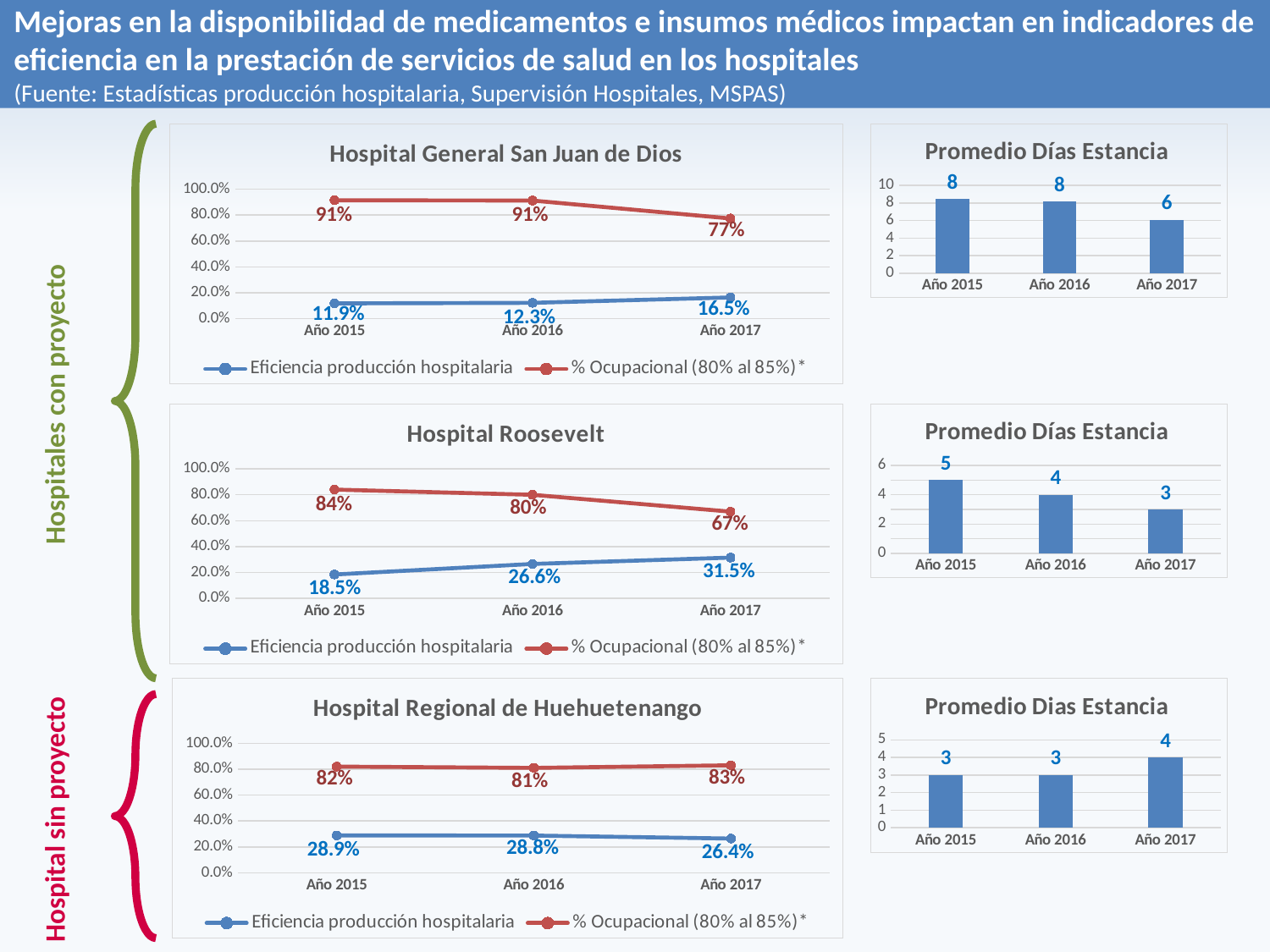
In the Hospital Roosevelt chart, what is the difference between the % Ocupacional values for Año 2015 and Año 2017? 17% In the Hospital General San Juan de Dios chart, which is larger: Eficiencia producción hospitalaria for Año 2016 or for Año 2017? Año 2017 In the Hospital General San Juan de Dios chart, what is the % Ocupacional value for Año 2015? 91% How many series does the legend of the Hospital Roosevelt chart list? 2 In the Hospital Regional de Huehuetenango chart, which year has the lowest Eficiencia producción hospitalaria value? Año 2017 In the bottom-right Promedio Dias Estancia chart (next to Hospital Regional de Huehuetenango), what is the difference between Año 2017 and Año 2015? 1 In the Hospital General San Juan de Dios chart, what is the value of Eficiencia producción hospitalaria for Año 2017? 16.5% In the Hospital Roosevelt chart, does Eficiencia producción hospitalaria rise or fall from Año 2015 to Año 2017? rise In the top-right Promedio Días Estancia chart (next to Hospital General San Juan de Dios), what is the value for Año 2017? 6 In the Hospital Regional de Huehuetenango chart, what is the % Ocupacional value for Año 2016? 81% In the middle-right Promedio Días Estancia chart (next to Hospital Roosevelt), which year has the highest value? Año 2015 What kind of chart is the top-right Promedio Días Estancia chart? bar chart